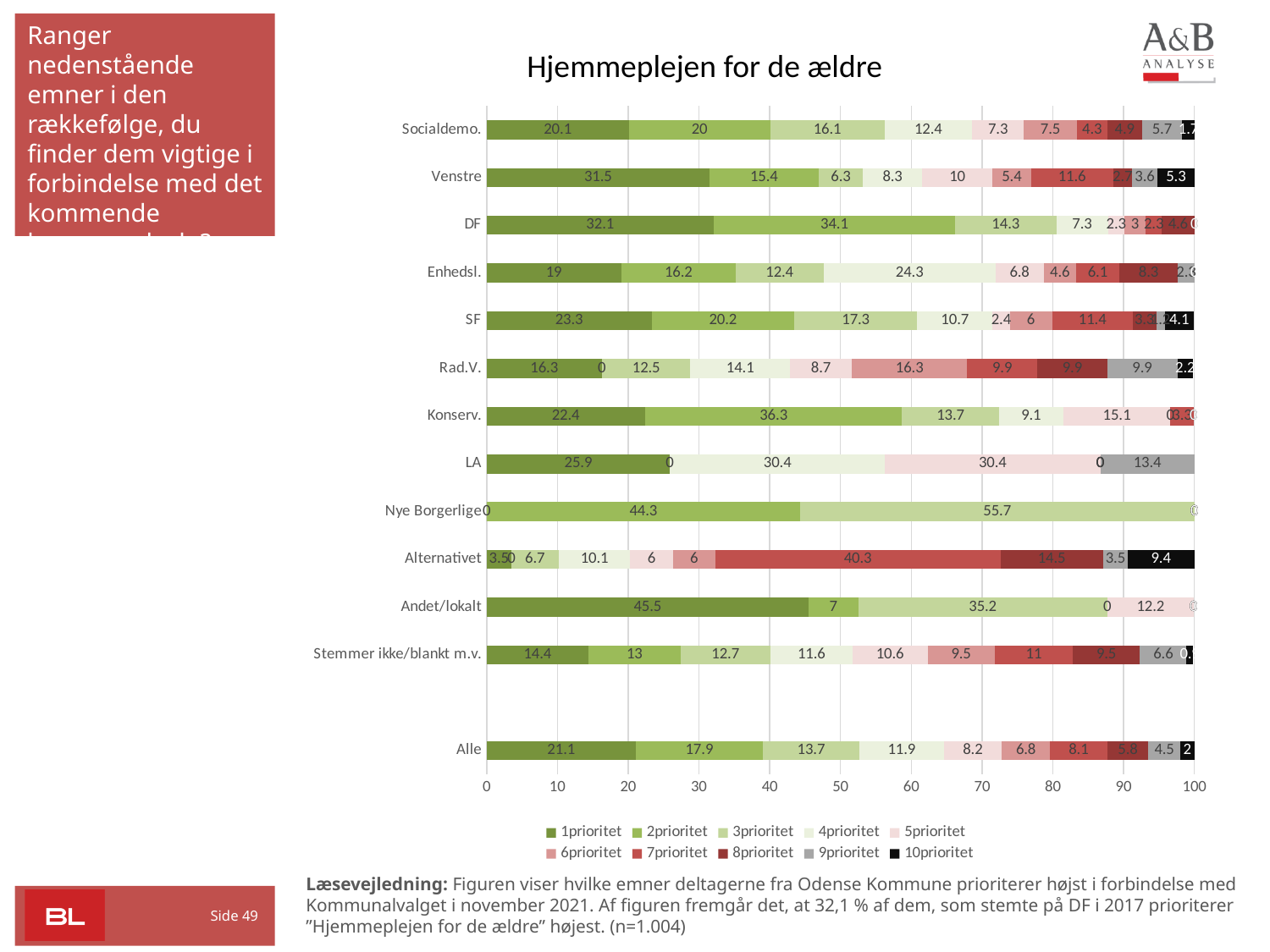
What is the 3prioritet value for Nye Borgerlige? 55.7 What is the difference between the 1prioritet values for DF and Venstre? 0.6 Which category has the highest 1prioritet value? Andet/lokalt What is the 1prioritet value for DF? 32.1 What is the title of the chart? Hjemmeplejen for de ældre How many categories are shown on the vertical axis of the chart? 13 What kind of chart is shown on the slide? bar chart What is the 1prioritet value for Andet/lokalt? 45.5 Is the 1prioritet value for Alle greater or less than 20? greater Which has the larger 2prioritet value, Konserv. or DF? Konserv. What is the 7prioritet value for Alternativet? 40.3 How many series does the legend list? 10